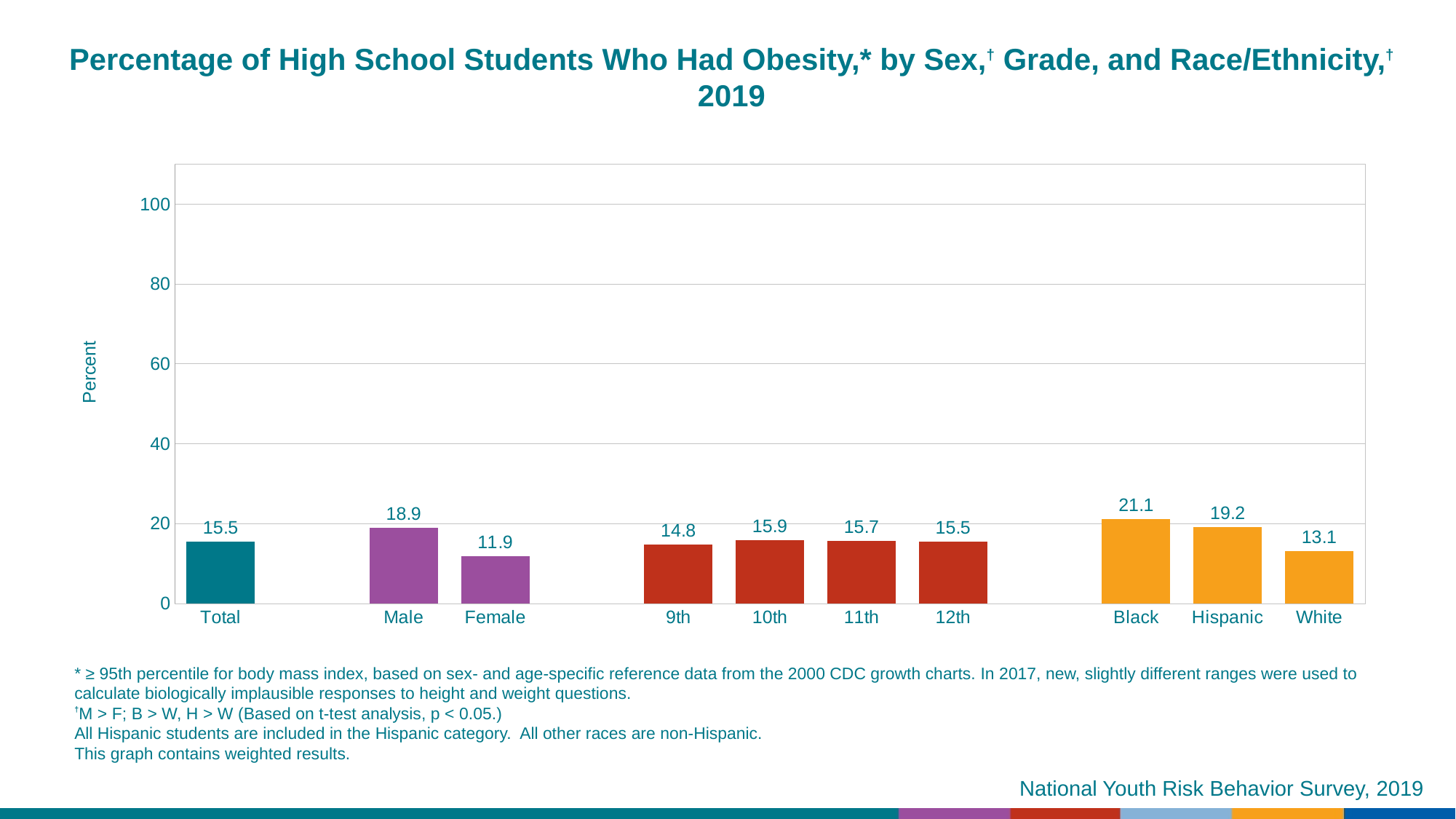
What is the label of the y axis? Percent What is the value for Hispanic? 19.2 Is the value for Black greater or less than 20? greater Which is larger, the value for 10th or the value for 9th? 10th What kind of chart is this? bar chart Which category has the lowest value? Female Which category has the highest value? Black What is the value for Female? 11.9 How many categories are shown on the x axis? 10 What is the value for Total? 15.5 What is the difference between the values for Black and White? 8.0 What is the difference between the values for Male and Female? 7.0